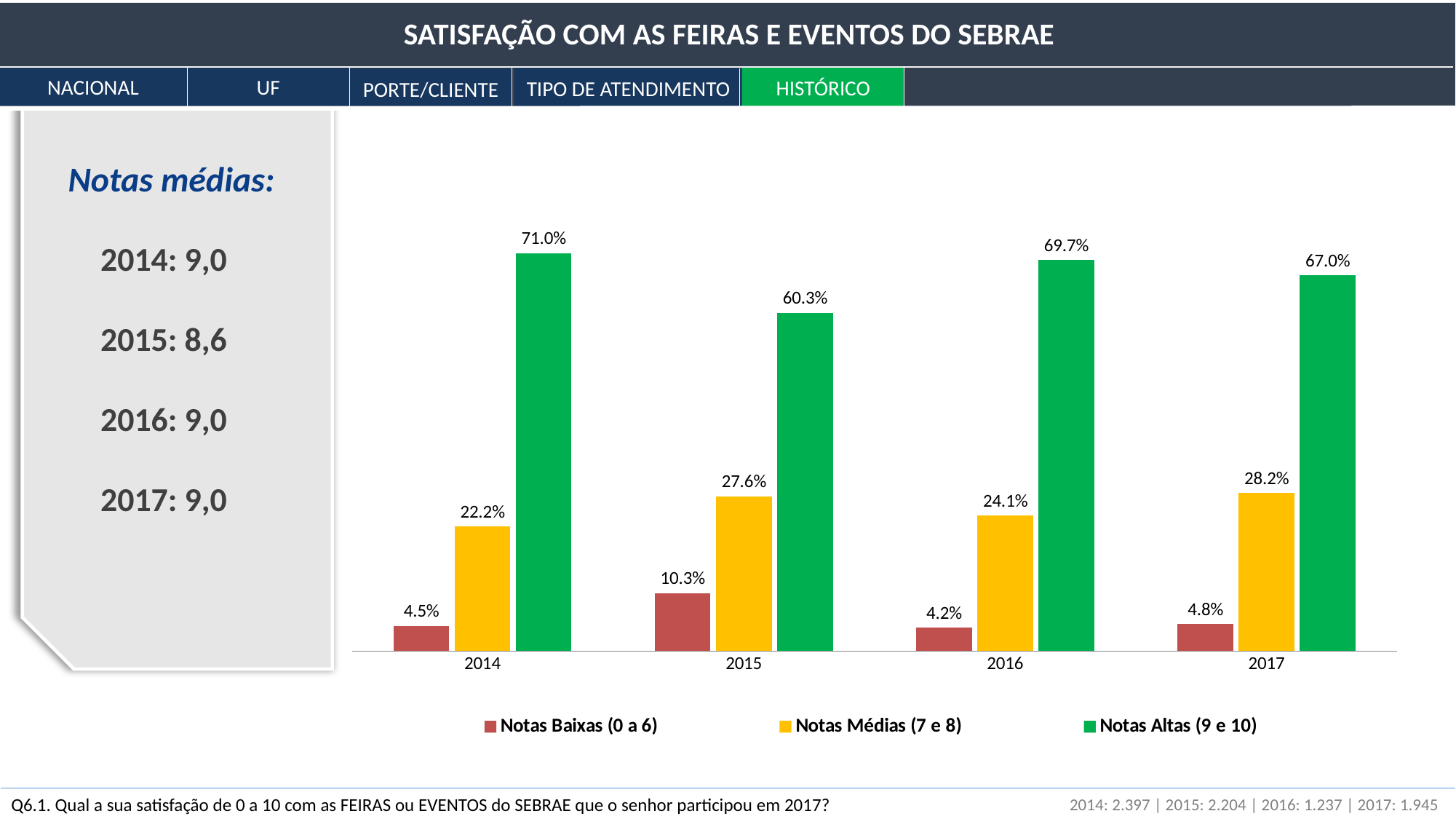
How many years are shown on the x axis? 4 What is the value for Notas Médias (7 e 8) in 2017? 28.2% What is the value for Notas Altas (9 e 10) in 2014? 71.0% What is the value for Notas Baixas (0 a 6) in 2015? 10.3% How many series does the legend list? 3 What is the difference between the Notas Altas (9 e 10) values for 2014 and 2017? 4.0% Which is larger: Notas Médias (7 e 8) in 2015 or in 2016? 2015 In which year is the Notas Baixas (0 a 6) value highest? 2015 In which year is the Notas Altas (9 e 10) value lowest? 2015 What kind of chart is shown? Bar chart What colour represents Notas Altas (9 e 10) in the chart? Green Does the Notas Altas (9 e 10) value rise or fall from 2016 to 2017? Fall